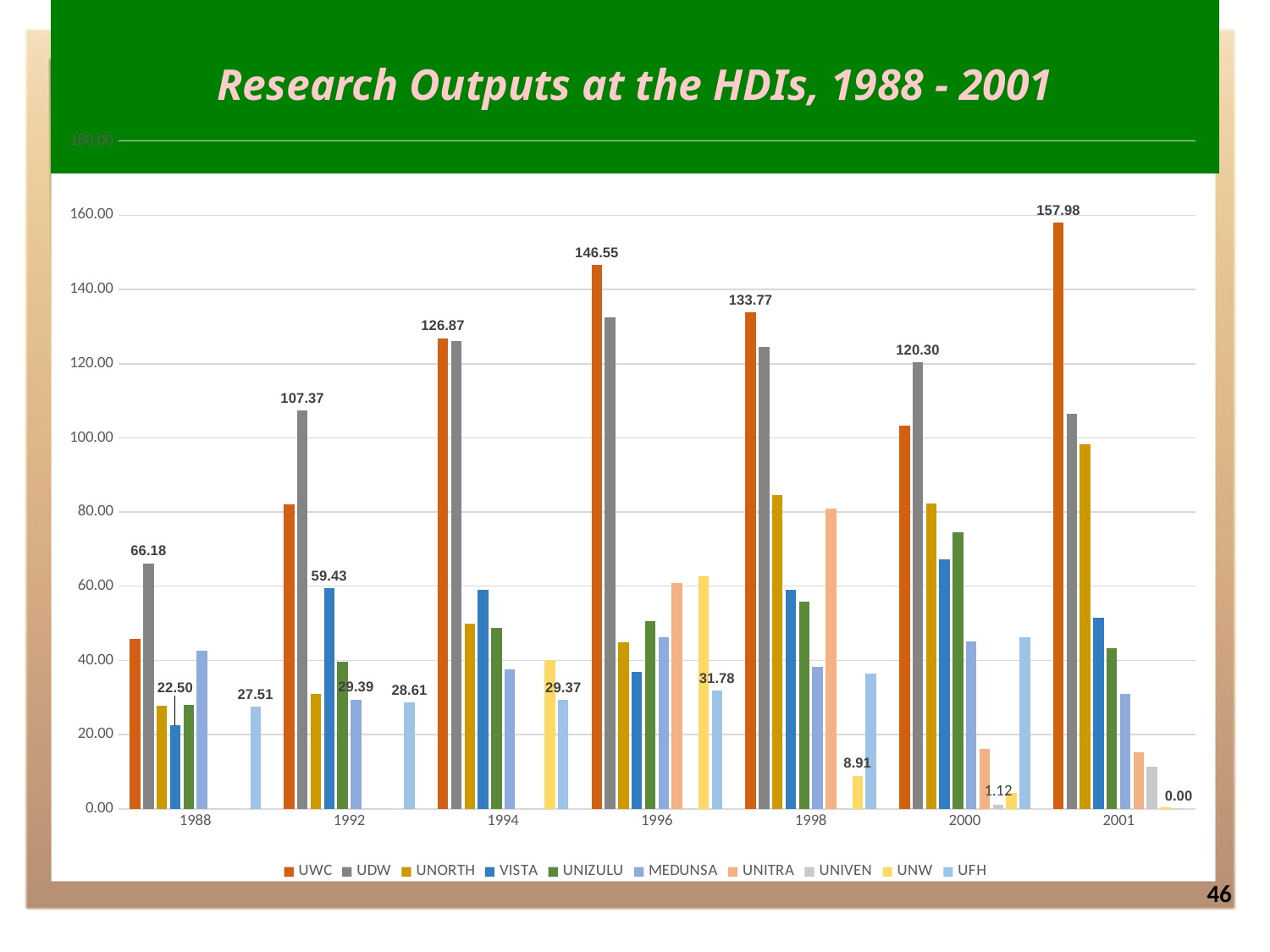
Which is larger, the UWC value in 1996 or the UWC value in 1998? 1996 What is the value for UDW in 1988? 66.18 What is the value for UWC in 2001? 157.98 How many series does the legend list? 10 What is the difference between the UWC value in 2001 and the UWC value in 1996? 11.43 What is the value for UFH in 1996? 31.78 Is the value for UNITRA in 1998 greater or less than 60.00? greater What is the value for VISTA in 1992? 59.43 What is the value for UNIVEN in 2000? 1.12 How many years are shown on the x axis? 7 What kind of chart is shown on the slide? bar chart Which year contains the tallest bar in the chart? 2001